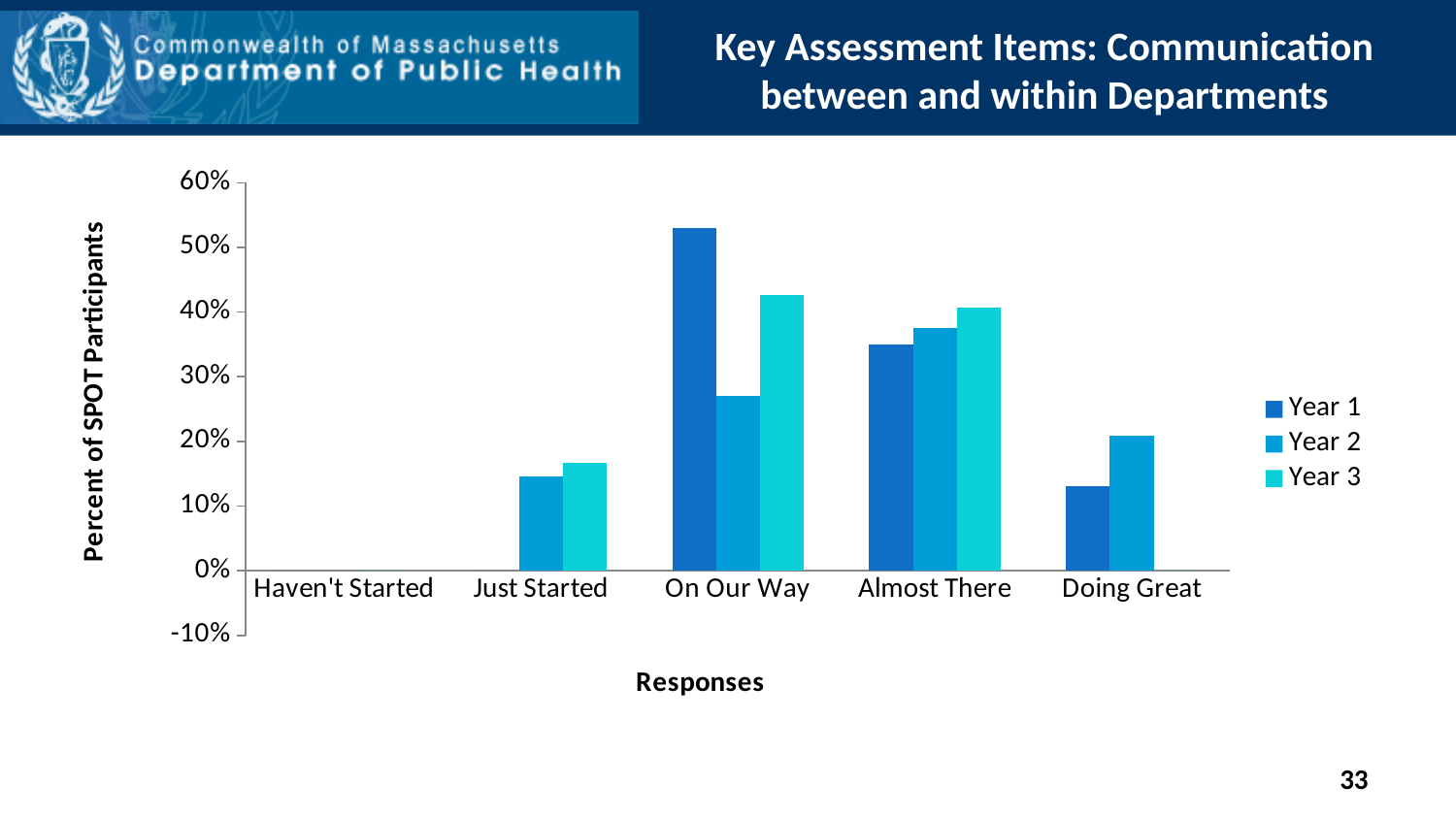
How many response categories are shown on the x axis? 5 What is the title of the vertical axis? Percent of SPOT Participants Which response category has the highest value for Year 2? Almost There For On Our Way, which is larger: the Year 1 value or the Year 3 value? Year 1 For Doing Great, which is larger: the Year 1 value or the Year 2 value? Year 2 Is the Year 1 value for Doing Great greater or less than 10%? greater Is the Year 2 value for On Our Way greater or less than 30%? less Is the Year 1 value for On Our Way greater or less than 50%? greater What kind of chart is shown on the slide? bar chart Which response category has the highest value for Year 1? On Our Way How many series does the legend list? 3